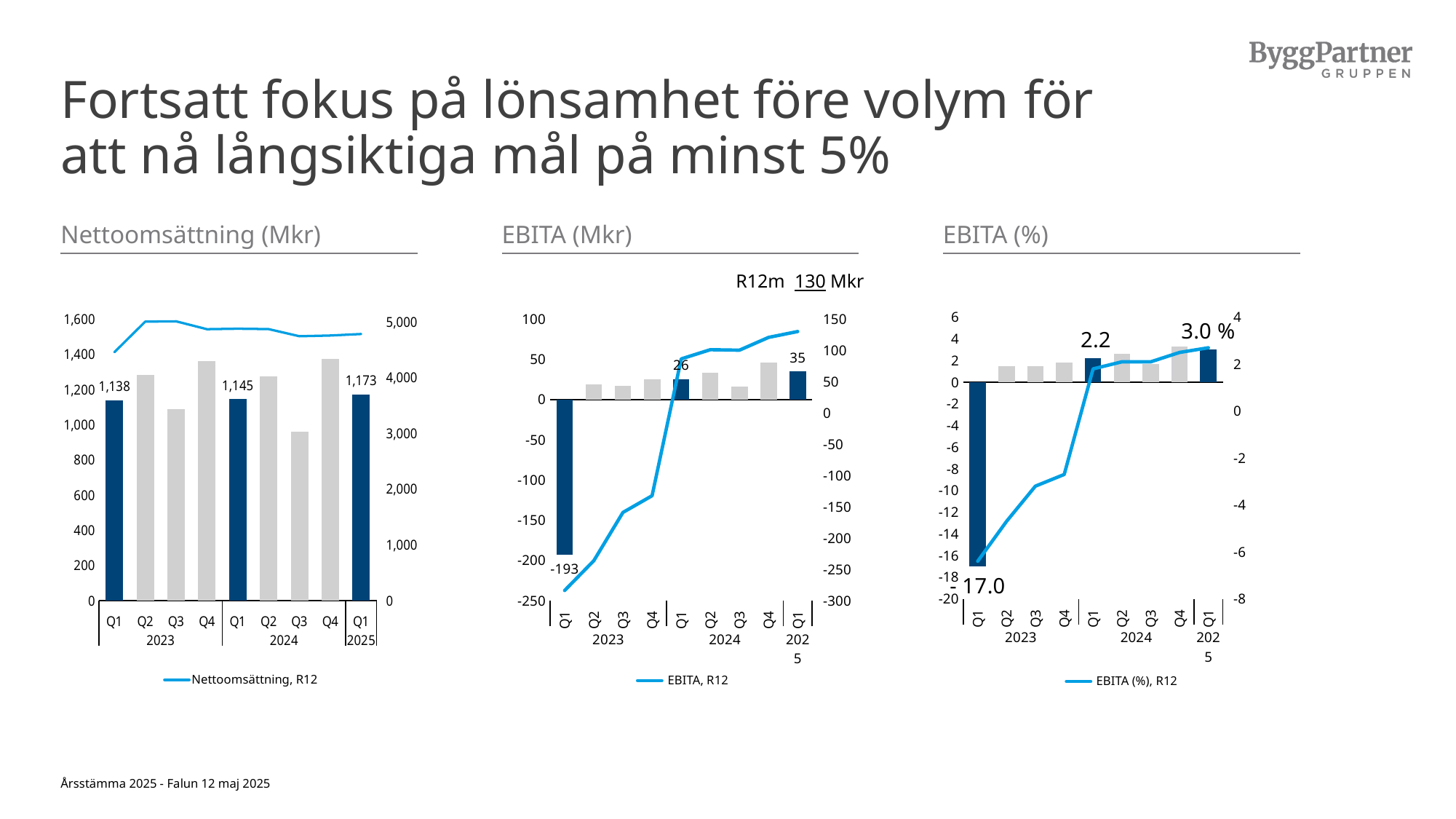
In the Nettoomsättning (Mkr) chart, what is the value for Q1 2025? 1,173 In the EBITA (Mkr) chart, which is larger, the Q1 2025 value or the Q1 2024 value? Q1 2025 In the Nettoomsättning (Mkr) chart, is the value for Q3 2024 greater or less than 1,000? less In the EBITA (Mkr) chart, which quarter has the lowest bar? Q1 2023 What kind of chart is the EBITA (%) chart? Bar chart with a line In the EBITA (Mkr) chart, what is the value for Q1 2023? -193 In the EBITA (Mkr) chart, what is the difference between the Q1 2025 and Q1 2024 values? 9 In the EBITA (%) chart, what is the value for Q1 2024? 2.2 In the Nettoomsättning (Mkr) chart, what is the difference between the Q1 2025 and Q1 2024 values? 28 In the EBITA (Mkr) chart, does the EBITA, R12 line rise or fall from Q1 2023 to Q1 2025? Rise In the Nettoomsättning (Mkr) chart, how many quarterly bars are plotted? 9 In the EBITA (Mkr) chart, what R12m value is printed above the chart? 130 Mkr